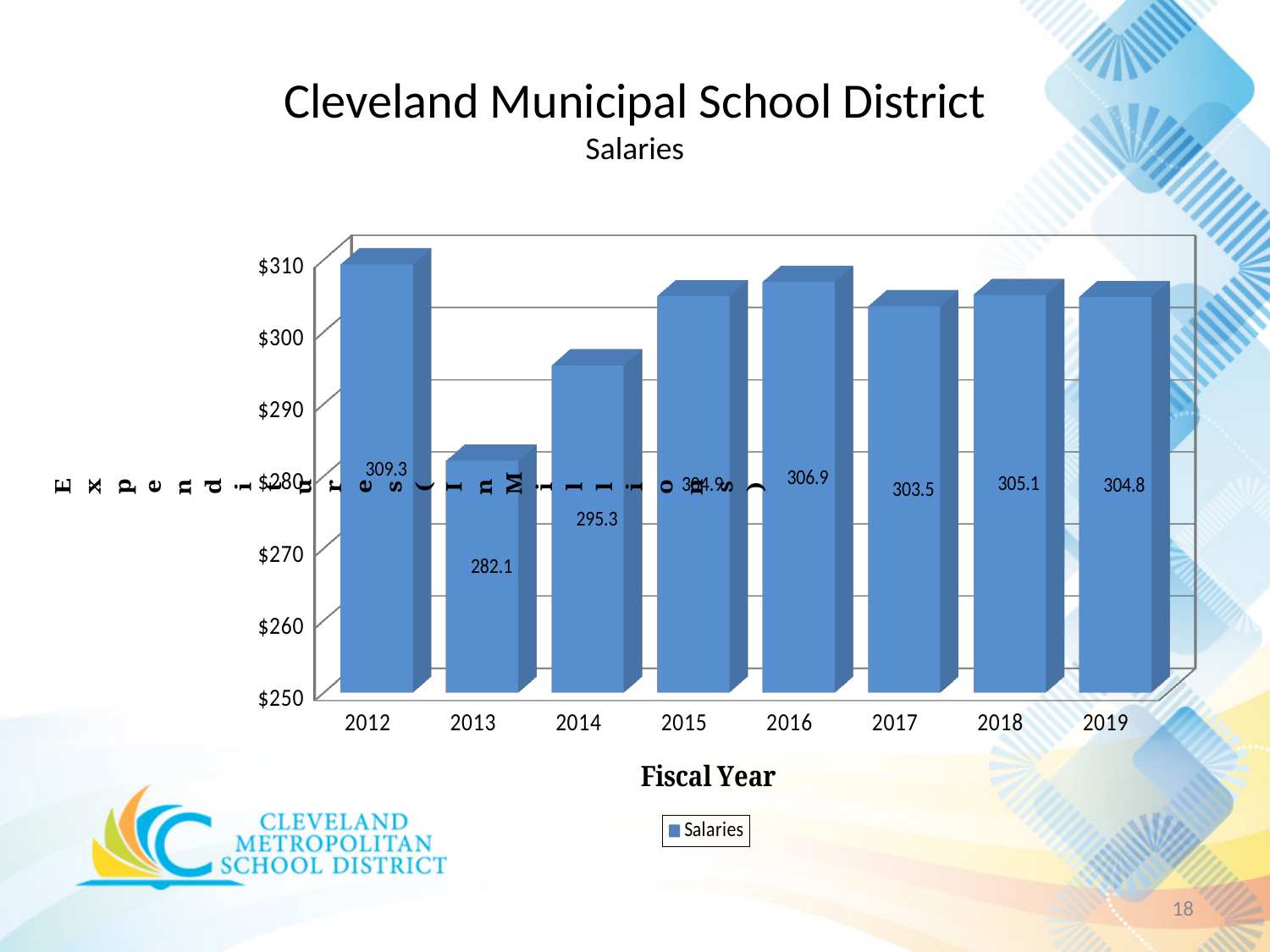
What is the value for 2012? 309.3 Is the value for 2014 greater or less than $300? less What is the value for 2013? 282.1 How many fiscal years are shown on the x axis? 8 What is the value for 2019? 304.8 How many series does the legend list? 1 What is the value for 2016? 306.9 Which is larger, the value for 2018 or the value for 2017? 2018 What is the difference between the values for 2012 and 2013? 27.2 Which fiscal year has the lowest value? 2013 What kind of chart is shown on the slide? bar chart Which fiscal year has the highest value? 2012